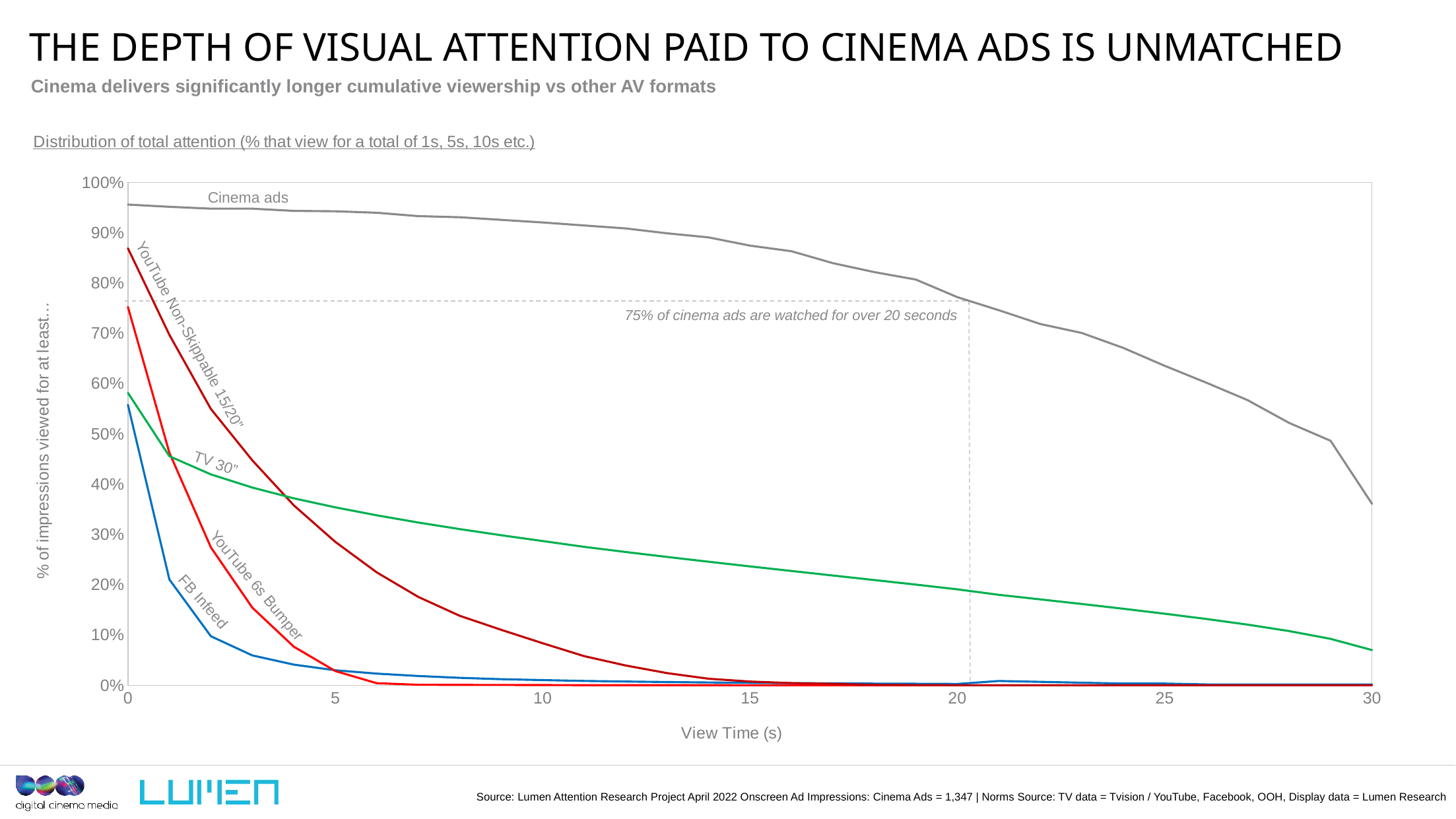
Which series has the lowest value at a view time of 0 seconds? FB Infeed What is the label of the x axis? View Time (s) How many series (lines) are plotted on the chart? 5 According to the annotation on the chart, what percentage of cinema ads are watched for over 20 seconds? 75% Is the value for YouTube Non-Skippable 15/20" at 10 seconds greater or less than 20%? less Is the value for Cinema ads at 30 seconds greater or less than 30%? greater Do the values for Cinema ads rise or fall as view time increases? fall At a view time of 0 seconds, which is larger: YouTube 6s Bumper or TV 30"? YouTube 6s Bumper Which series has the highest value at a view time of 20 seconds? Cinema ads At a view time of 5 seconds, which is larger: TV 30" or YouTube Non-Skippable 15/20"? TV 30" What kind of chart is shown on the slide? line chart